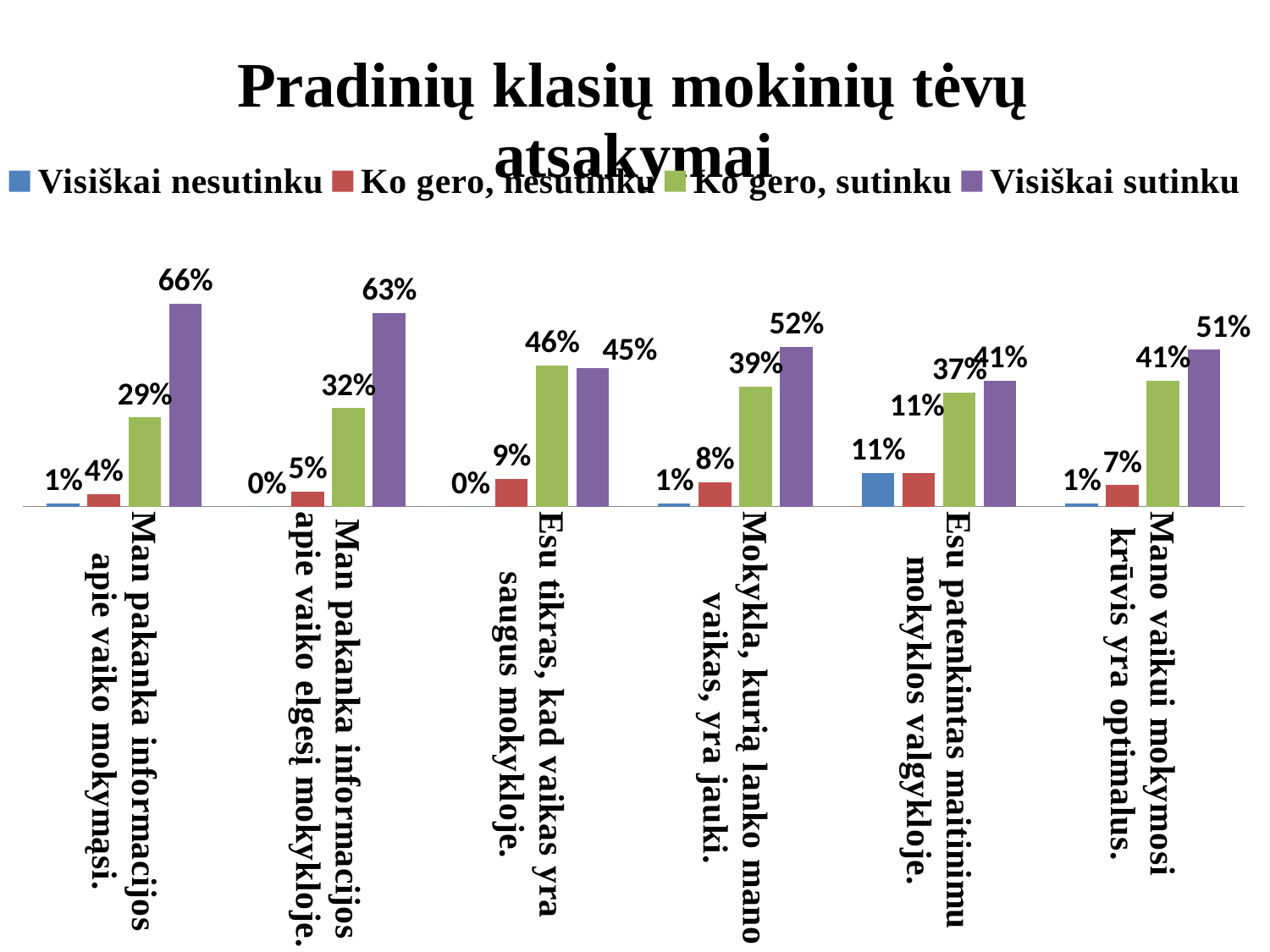
What is the value of "Visiškai sutinku" for "Man pakanka informacijos apie vaiko mokymąsi"? 66% How many categories are shown on the x axis? 6 What is the difference between the "Visiškai sutinku" and "Ko gero, sutinku" values for "Mokykla, kurią lanko mano vaikas, yra jauki"? 13% What is the value of "Visiškai nesutinku" for "Esu patenkintas maitinimu mokyklos valgykloje"? 11% Which category has the lowest "Ko gero, sutinku" value? Man pakanka informacijos apie vaiko mokymąsi What is the value of "Ko gero, sutinku" for "Esu tikras, kad vaikas yra saugus mokykloje"? 46% How many series does the legend list? 4 What is the title of the chart? Pradinių klasių mokinių tėvų atsakymai What is the value of "Ko gero, nesutinku" for "Mano vaikui mokymosi krūvis yra optimalus"? 7% Which category has the highest "Visiškai sutinku" value? Man pakanka informacijos apie vaiko mokymąsi What kind of chart is shown on the slide? Bar chart Which is larger for "Man pakanka informacijos apie vaiko elgesį mokykloje": "Ko gero, sutinku" or "Visiškai sutinku"? Visiškai sutinku